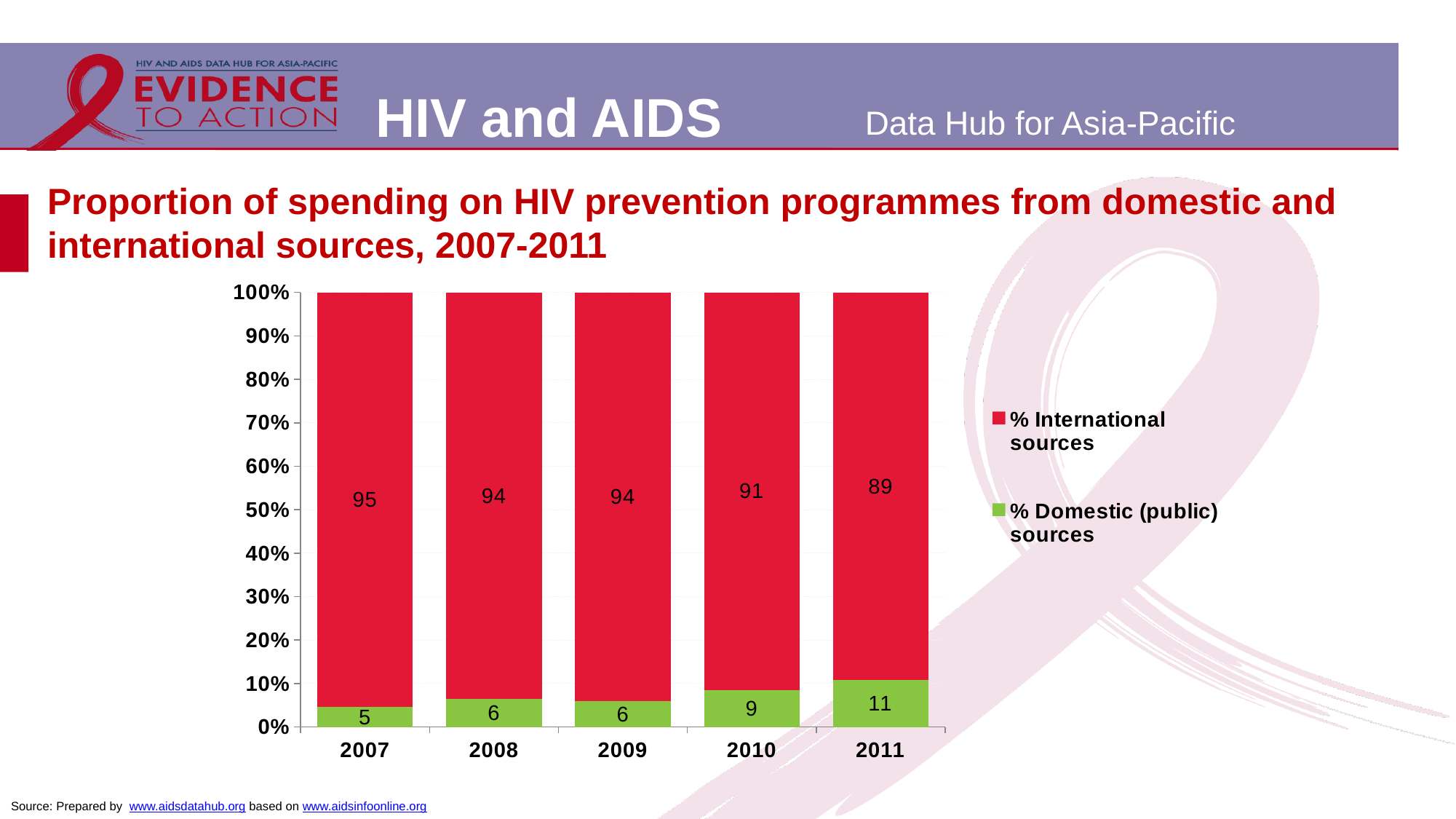
Which is larger: the % Domestic (public) sources value in 2008 or in 2010? 2010 What is the value for % Domestic (public) sources in 2010? 9 What kind of chart is shown on the slide? stacked bar chart What is the value for % International sources in 2007? 95 In which year is the % Domestic (public) sources value highest? 2011 In which year is the % International sources value lowest? 2011 What is the value for % Domestic (public) sources in 2011? 11 Which colour represents % International sources in the chart? red What is the difference between the % International sources values for 2007 and 2011? 6 How many years are shown on the x axis? 5 Does the % Domestic (public) sources value rise or fall from 2007 to 2011? rise How many series does the legend list? 2